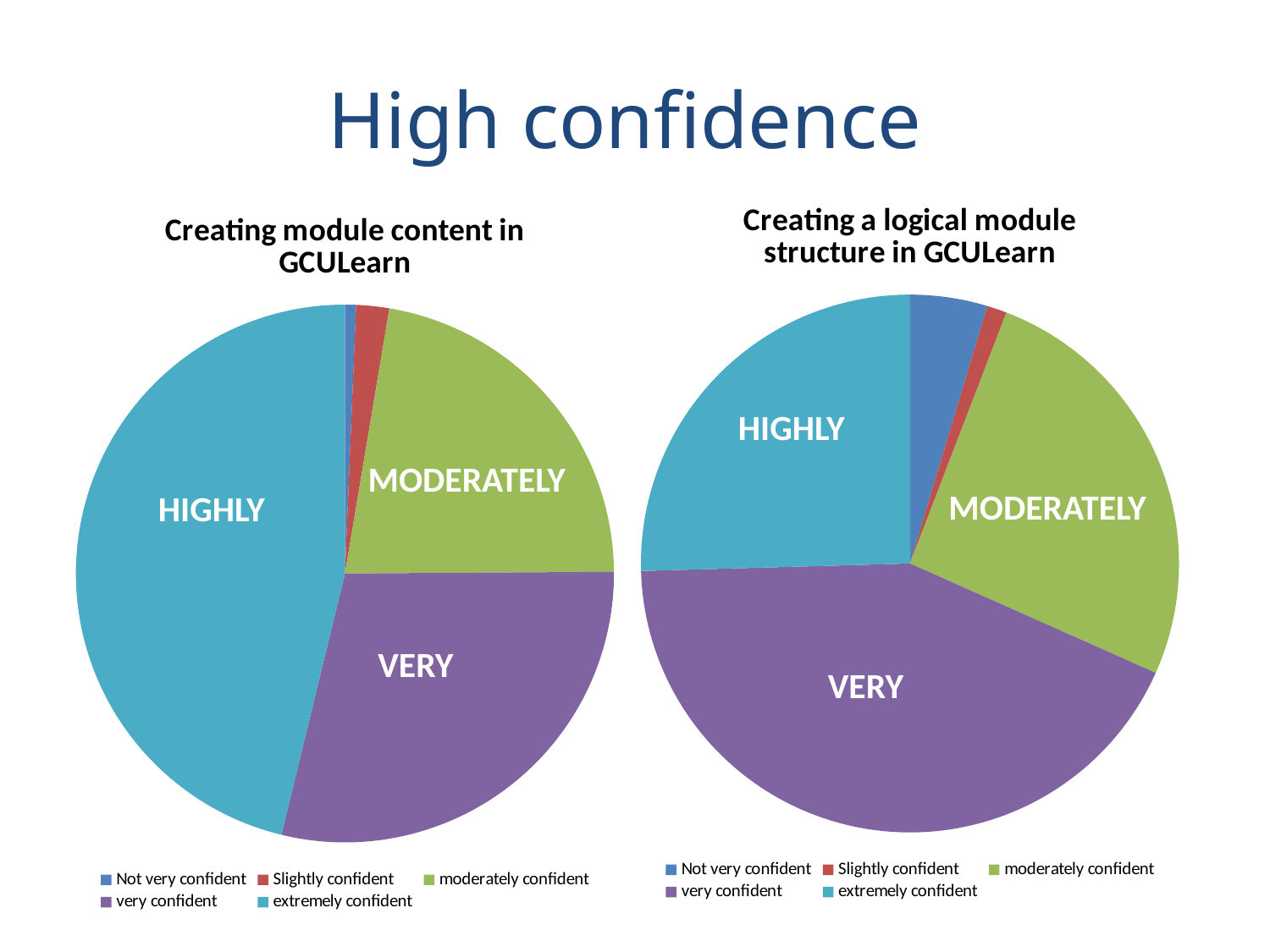
In the "Creating module content in GCULearn" chart, which slice is larger: extremely confident or very confident? extremely confident In the "Creating a logical module structure in GCULearn" chart, which slice is larger: Not very confident or Slightly confident? Not very confident In the "Creating a logical module structure in GCULearn" chart, which slice is larger: very confident or moderately confident? very confident In the "Creating a logical module structure in GCULearn" chart, which category has the largest slice? very confident What kind of chart is the "Creating module content in GCULearn" chart? pie chart In the "Creating module content in GCULearn" chart, which category has the largest slice? extremely confident In the "Creating a logical module structure in GCULearn" chart, how many categories does the legend list? 5 In the "Creating module content in GCULearn" chart, how many categories does the legend list? 5 What kind of chart is the "Creating a logical module structure in GCULearn" chart? pie chart What colour is the "very confident" slice in the charts on this slide? purple In the "Creating module content in GCULearn" chart, which category has the smallest slice? Not very confident In the "Creating a logical module structure in GCULearn" chart, which category has the smallest slice? Slightly confident